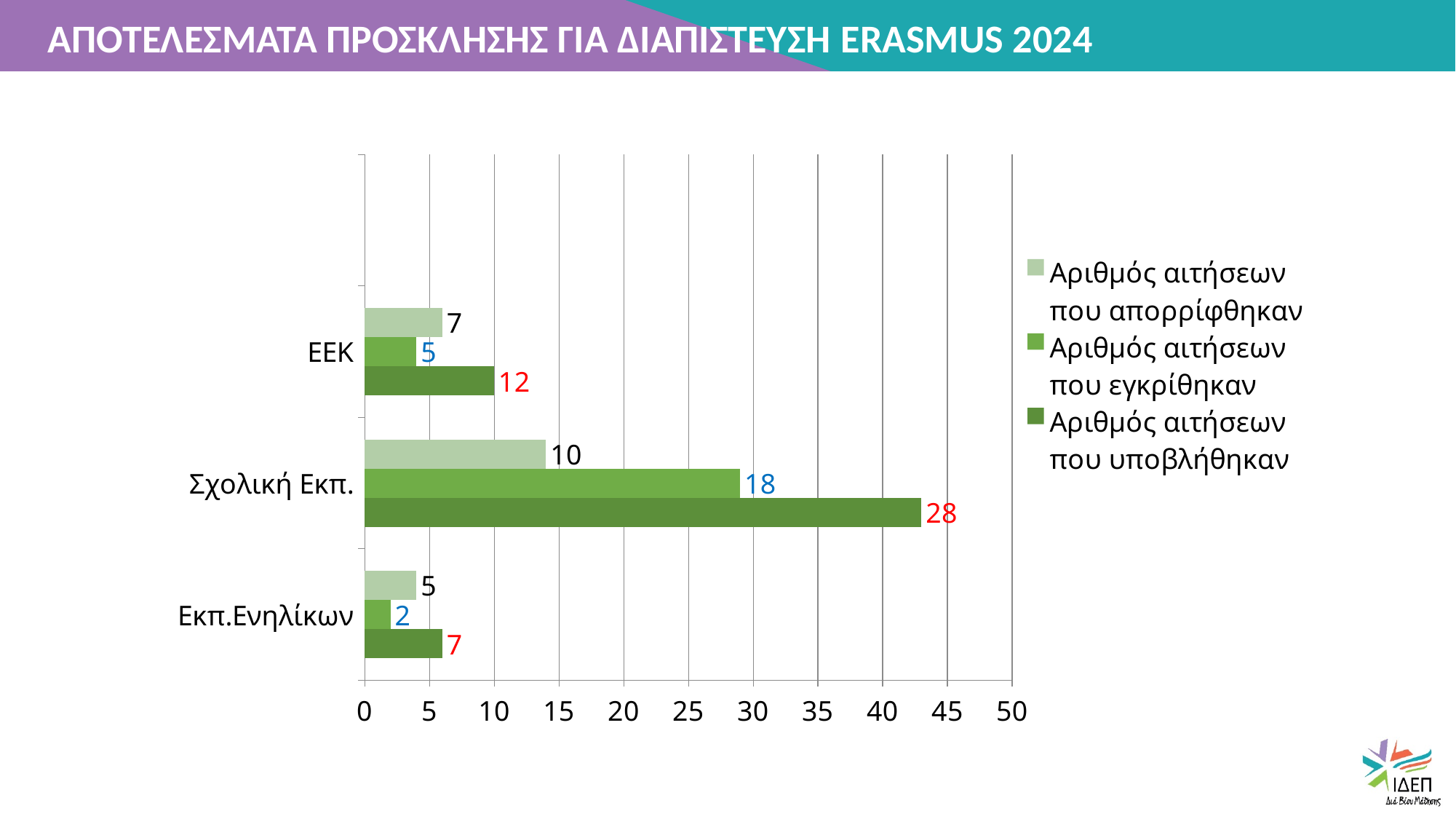
Which is larger for ΕΕΚ: 'Αριθμός αιτήσεων που απορρίφθηκαν' or 'Αριθμός αιτήσεων που εγκρίθηκαν'? Αριθμός αιτήσεων που απορρίφθηκαν What is the value of 'Αριθμός αιτήσεων που εγκρίθηκαν' for ΕΕΚ? 5 How many series does the legend list? 3 Which category has the highest value for 'Αριθμός αιτήσεων που υποβλήθηκαν'? Σχολική Εκπ. Which category has the lowest value for 'Αριθμός αιτήσεων που εγκρίθηκαν'? Εκπ.Ενηλίκων What is the difference between 'Αριθμός αιτήσεων που υποβλήθηκαν' for Σχολική Εκπ. and for ΕΕΚ? 16 How many categories are shown on the vertical axis? 3 What is the value of 'Αριθμός αιτήσεων που υποβλήθηκαν' for Σχολική Εκπ.? 28 What type of chart is shown on the slide? bar chart What is the difference between 'Αριθμός αιτήσεων που υποβλήθηκαν' and 'Αριθμός αιτήσεων που εγκρίθηκαν' for Σχολική Εκπ.? 10 What is the title of the slide containing the chart? ΑΠΟΤΕΛΕΣΜΑΤΑ ΠΡΟΣΚΛΗΣΗΣ ΓΙΑ ΔΙΑΠΙΣΤΕΥΣΗ ERASMUS 2024 What is the value of 'Αριθμός αιτήσεων που απορρίφθηκαν' for Εκπ.Ενηλίκων? 5